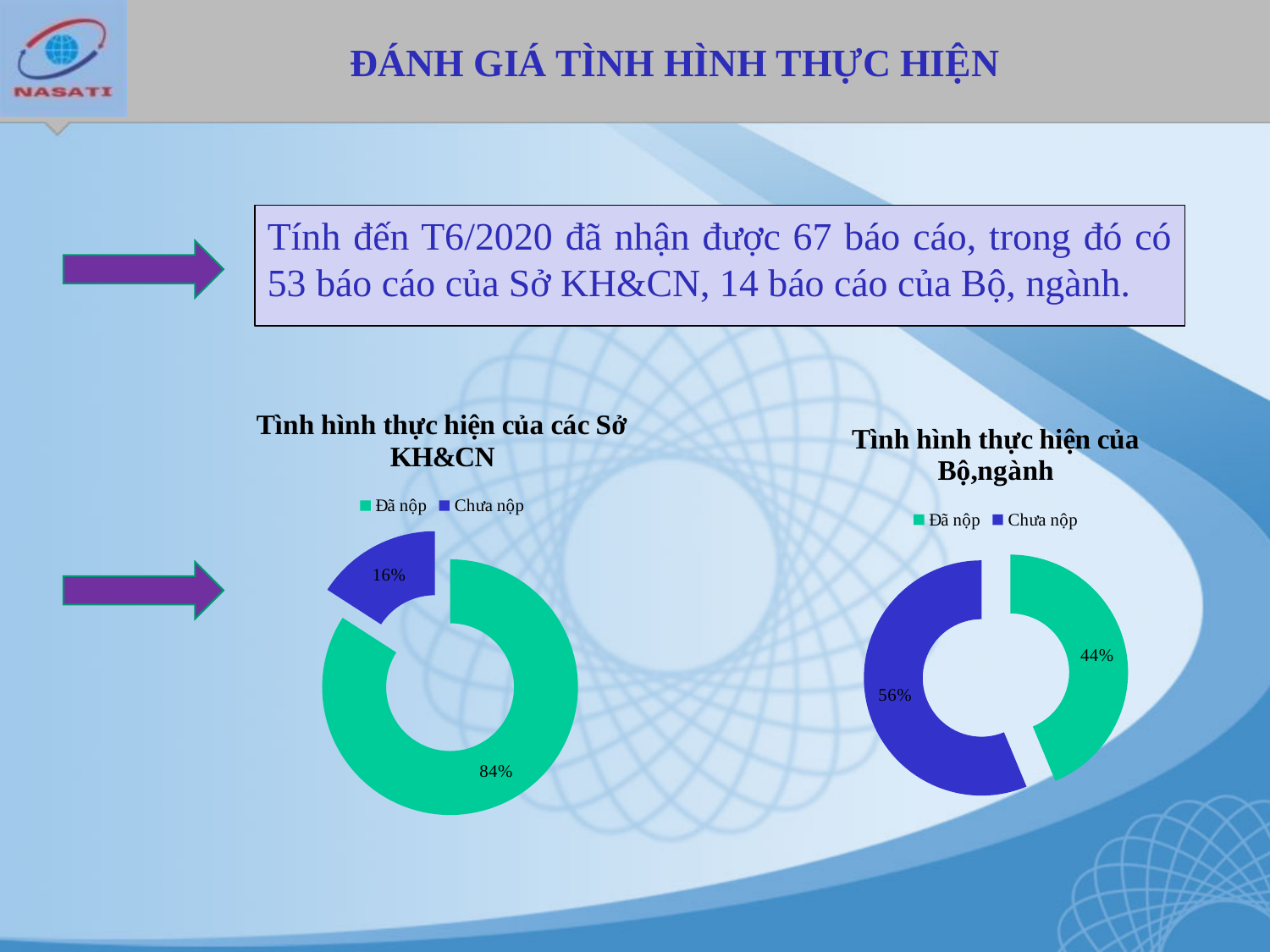
In the chart titled "Tình hình thực hiện của Bộ,ngành", what share is labelled for Đã nộp? 44% In the chart titled "Tình hình thực hiện của Bộ,ngành", what share is labelled for Chưa nộp? 56% How many categories does the legend of the left chart (các Sở KH&CN) list? 2 In the right chart (Bộ,ngành), what is the difference between the Chưa nộp and Đã nộp shares? 12% In the right chart (Bộ,ngành), which category has the smaller share? Đã nộp What kind of chart is used for "Tình hình thực hiện của Bộ,ngành"? Doughnut (pie) chart In the chart titled "Tình hình thực hiện của các Sở KH&CN", what share is labelled for Chưa nộp? 16% In the chart titled "Tình hình thực hiện của các Sở KH&CN", what share is labelled for Đã nộp? 84% In the right chart (Bộ,ngành), what colour represents Chưa nộp? Blue In the left chart (các Sở KH&CN), what is the difference between the Đã nộp and Chưa nộp shares? 68% Is the Đã nộp share larger in the left chart (các Sở KH&CN) or in the right chart (Bộ,ngành)? Left chart (các Sở KH&CN) In the left chart (các Sở KH&CN), which category has the larger share? Đã nộp